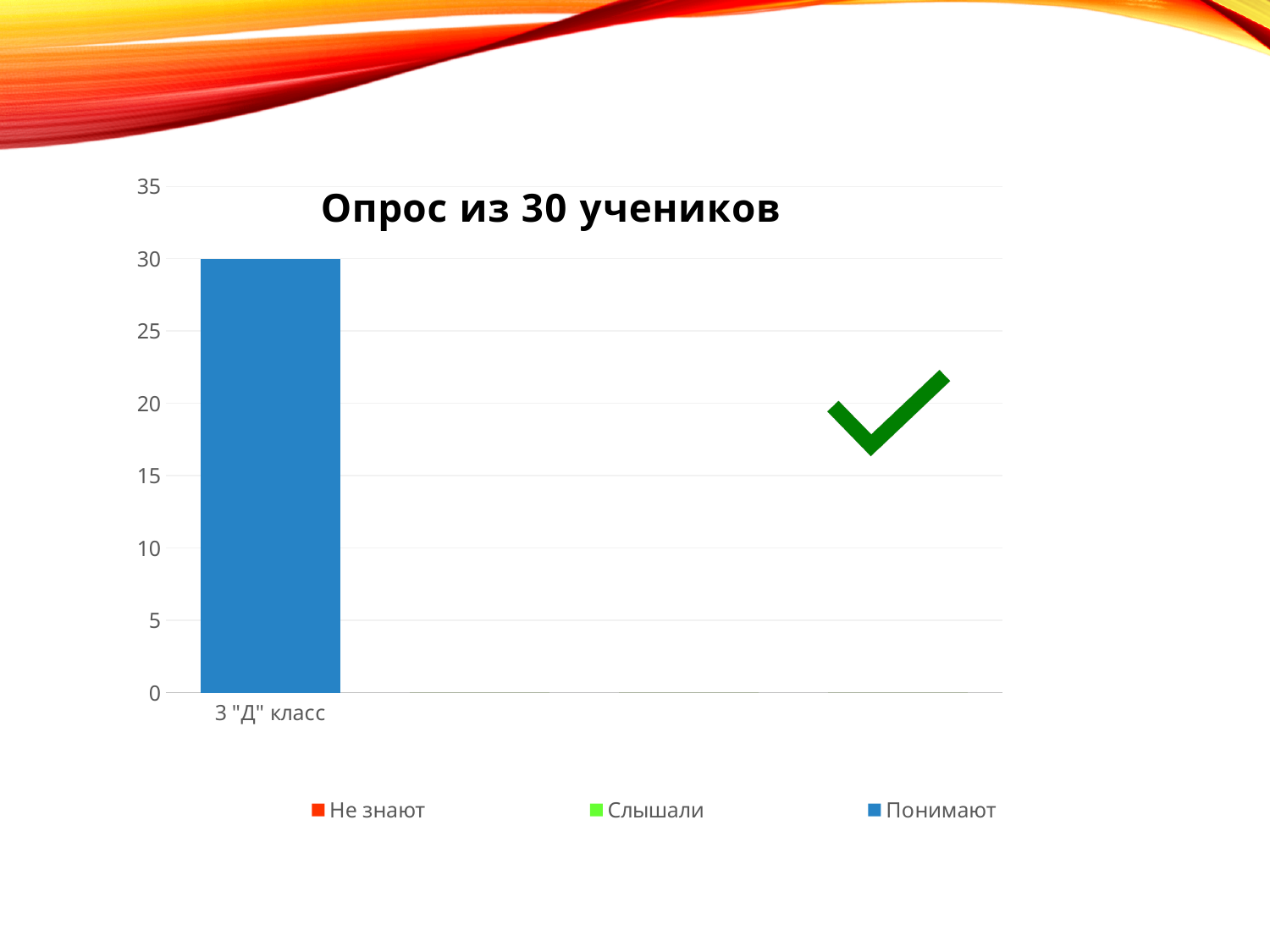
How many series does the legend list? 3 What kind of chart is shown on the slide? bar chart What is the highest value shown on the vertical axis? 35 What is the title of the chart? Опрос из 30 учеников Is the value for Понимают greater or less than 25? greater Which is larger for 3 "Д" класс: Понимают or Слышали? Понимают Is the value for Не знают greater or less than 5? less What colour represents the Понимают series in the legend? blue What is the label of the category on the x axis? 3 "Д" класс What is the value of the Понимают series for 3 "Д" класс? 30 How many categories are shown on the x axis? 1 Which series has the highest value for 3 "Д" класс? Понимают